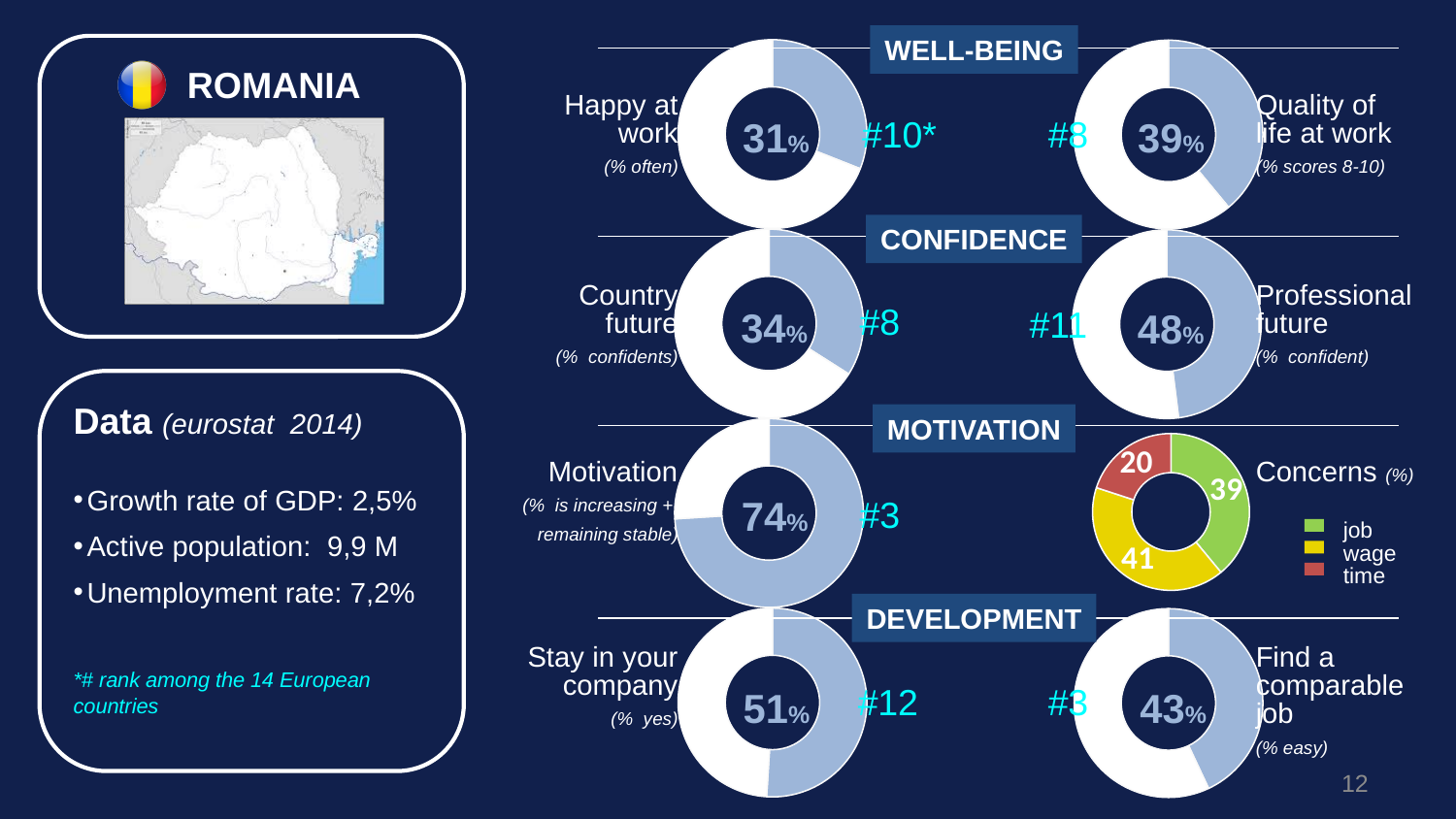
On the 'Quality of life at work' donut chart, what value is printed in the centre? 39% On the 'Happy at work' donut chart, what percentage is shown in the centre? 31% What is the difference between the 'Professional future' donut value and the 'Country future' donut value? 14% On the 'Professional future' donut chart, what percentage is shown? 48% Which is larger: the 'Stay in your company' donut value or the 'Find a comparable job' donut value? Stay in your company On the 'Motivation' donut chart, what percentage is displayed in the centre? 74% On the 'Concerns' pie chart, which slice has the smallest value? time On the 'Concerns' pie chart, what value is shown for the 'wage' slice? 41 How many entries does the legend of the 'Concerns' pie chart list? 3 What colour is the 'job' slice in the 'Concerns' pie chart? green On the 'Concerns' pie chart, which slice has the largest value? wage On the 'Concerns' pie chart, what is the difference between the 'wage' and 'time' values? 21